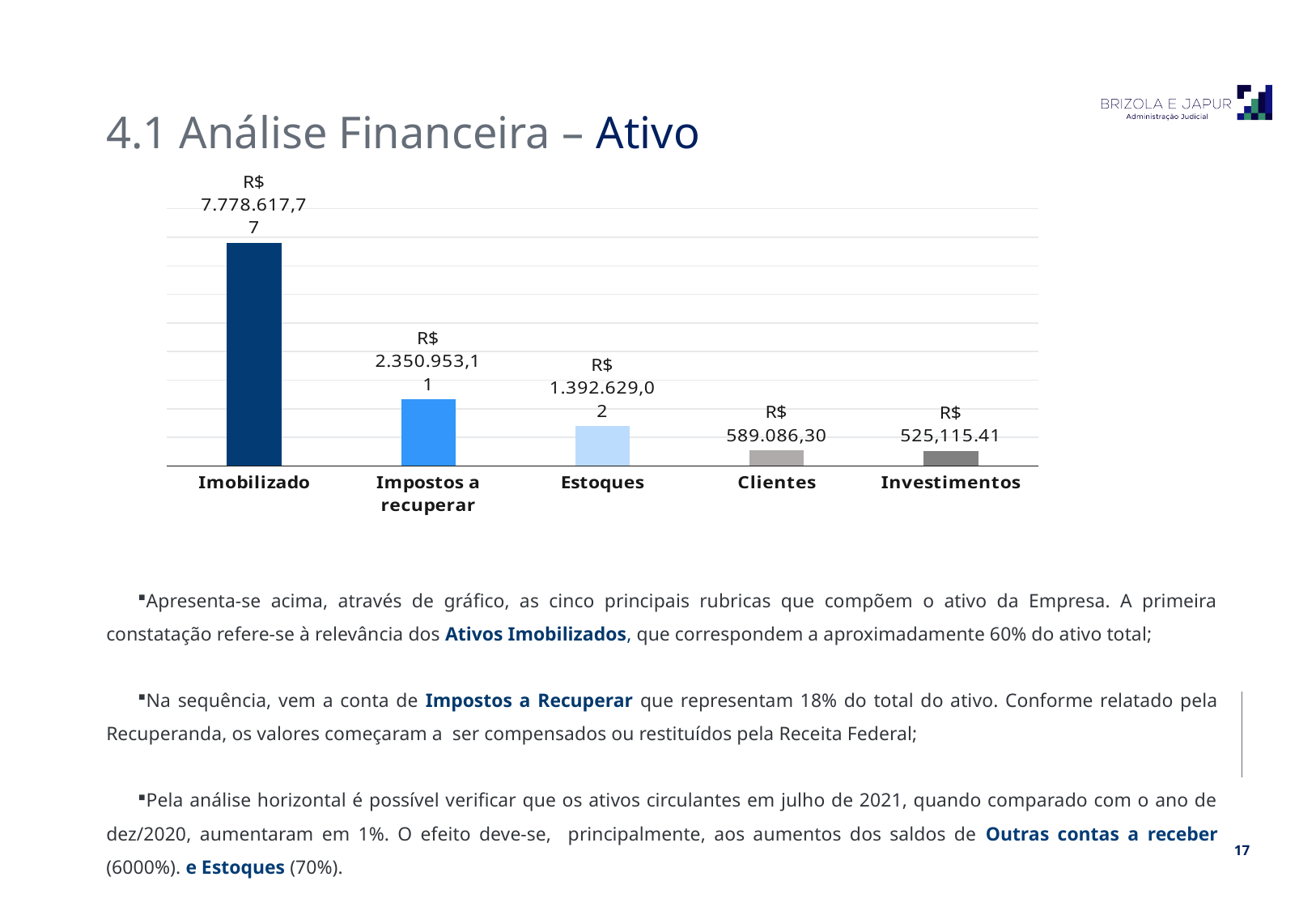
What is the value for Estoques? R$ 1.392.629,02 What is the value for Imobilizado? R$ 7.778.617,77 Which category has the highest value? Imobilizado What is the value for Clientes? R$ 589.086,30 What is the value for Investimentos? R$ 525,115.41 What is the difference between the values for Imobilizado and Impostos a recuperar? R$ 5.427.664,66 What is the difference between the values for Estoques and Clientes? R$ 803.542,72 Which is larger, the value for Clientes or the value for Investimentos? Clientes How many categories are shown in the chart? 5 What is the value for Impostos a recuperar? R$ 2.350.953,11 What kind of chart is shown on the slide? Bar chart Which category has the lowest value? Investimentos